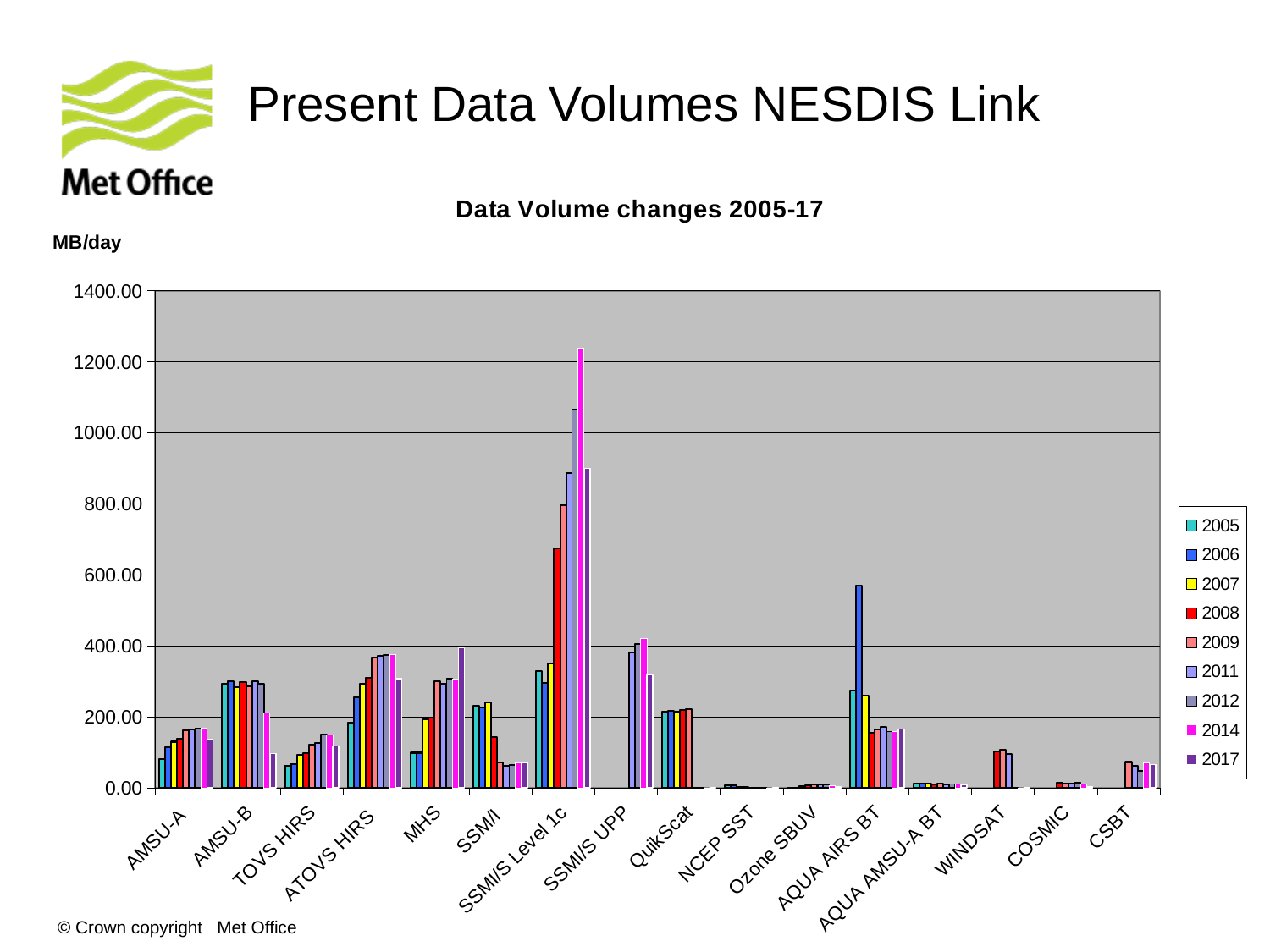
What is the title of the chart? Data Volume changes 2005-17 Is the 2006 value for AQUA AIRS BT greater or less than 600? less For SSMI/S Level 1c, which is larger: the 2014 value or the 2017 value? 2014 How many series does the legend list? 9 Is the 2014 value for SSMI/S UPP greater or less than 400? greater What kind of chart is shown on the slide? bar chart Which series has the highest value for AQUA AIRS BT? 2006 What unit is given for the y axis? MB/day Which series has the highest value for SSMI/S Level 1c? 2014 Is the 2014 value for SSMI/S Level 1c greater or less than 1200? greater How many categories are shown along the x axis? 16 Which category has the tallest bar in the chart? SSMI/S Level 1c